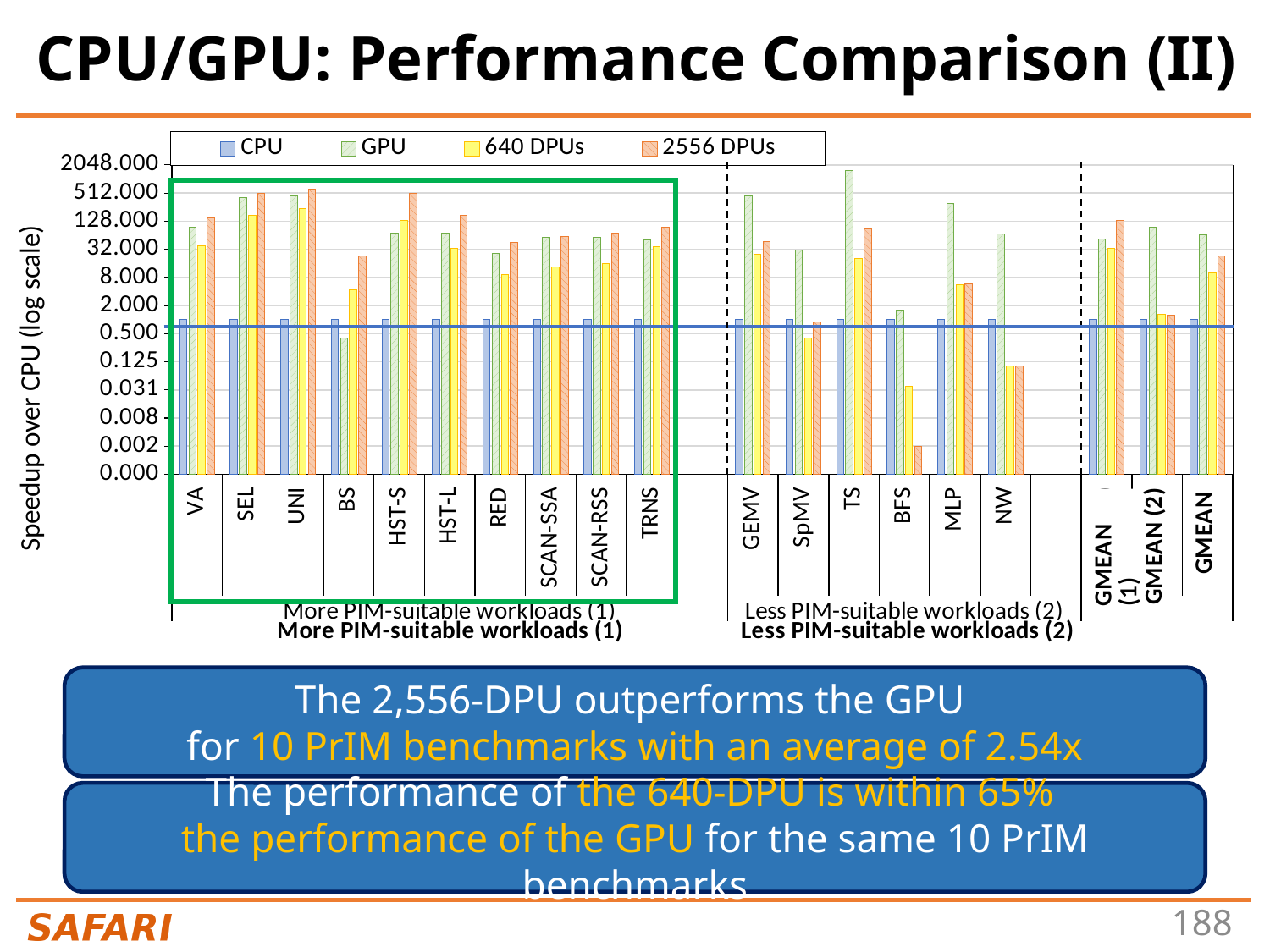
How many workload categories (including the GMEAN entries) are shown on the x axis? 19 What kind of chart is shown on the slide? bar chart Is the GPU value for TS greater or less than 512.000? greater Is the 2556 DPUs value for BFS greater or less than 0.008? less How many series does the legend list? 4 For BS, which is larger: the GPU value or the 2556 DPUs value? 2556 DPUs Is the 640 DPUs value for NW greater or less than 0.500? less Which workload has the lowest 2556 DPUs speedup? BFS For MLP, which is larger: the GPU value or the 2556 DPUs value? GPU What are the series listed in the legend? CPU, GPU, 640 DPUs, 2556 DPUs Which workload has the highest GPU speedup? TS What is the label of the y axis? Speedup over CPU (log scale)